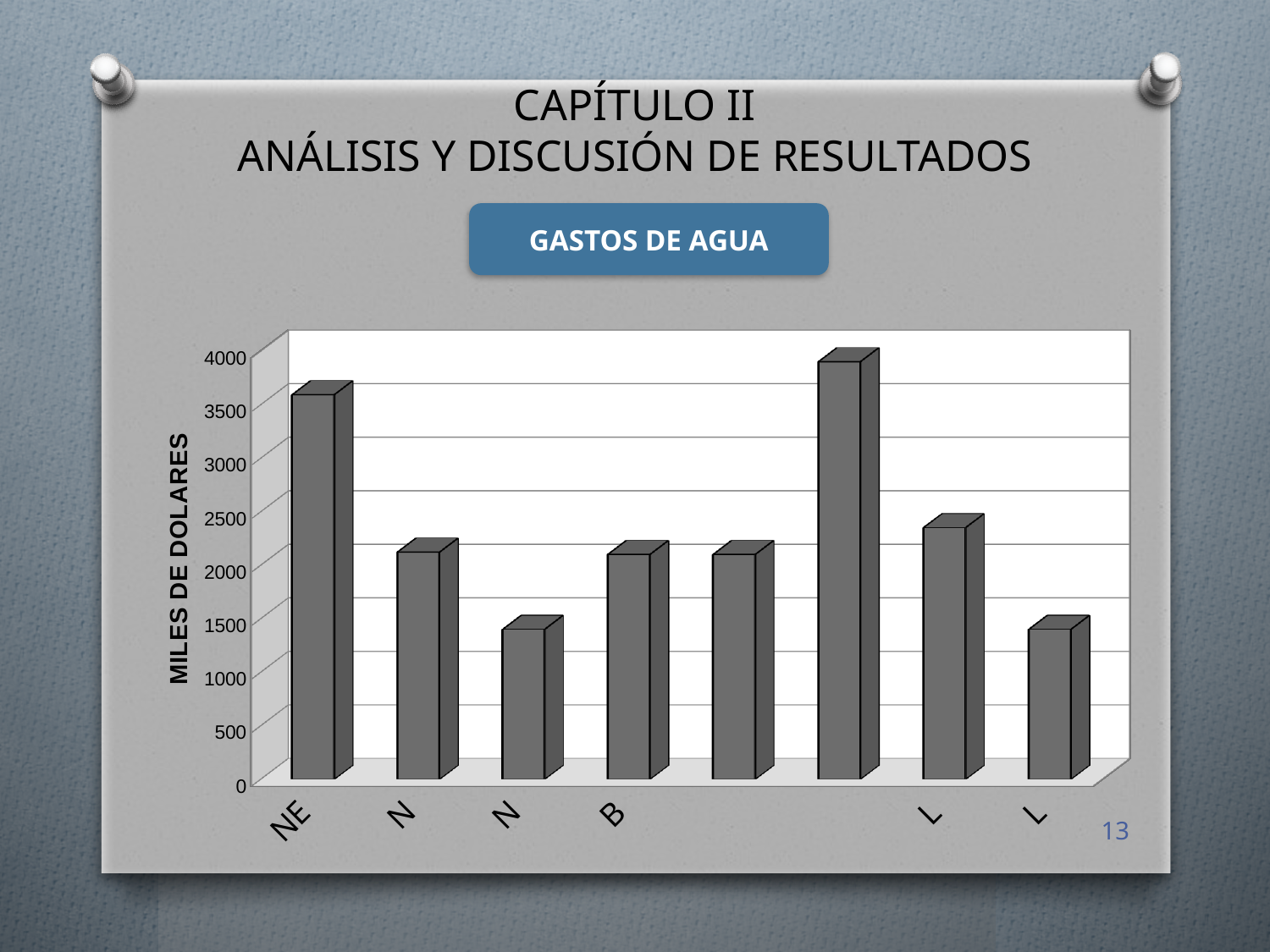
What is the title shown above the chart? GASTOS DE AGUA Is the value for NE greater or less than 4000? less What is the highest tick value shown on the vertical axis? 4000 Is the bar for NE the tallest bar in the chart? No How many bars exceed 3000 on the vertical axis? 2 Is the value for B greater or less than 1500? greater Is the value for B greater or less than 2500? less What kind of chart is shown on the slide? Bar chart What is the label of the vertical axis? MILES DE DOLARES Which has the larger value, NE or B? NE How many bars are plotted in the chart? 8